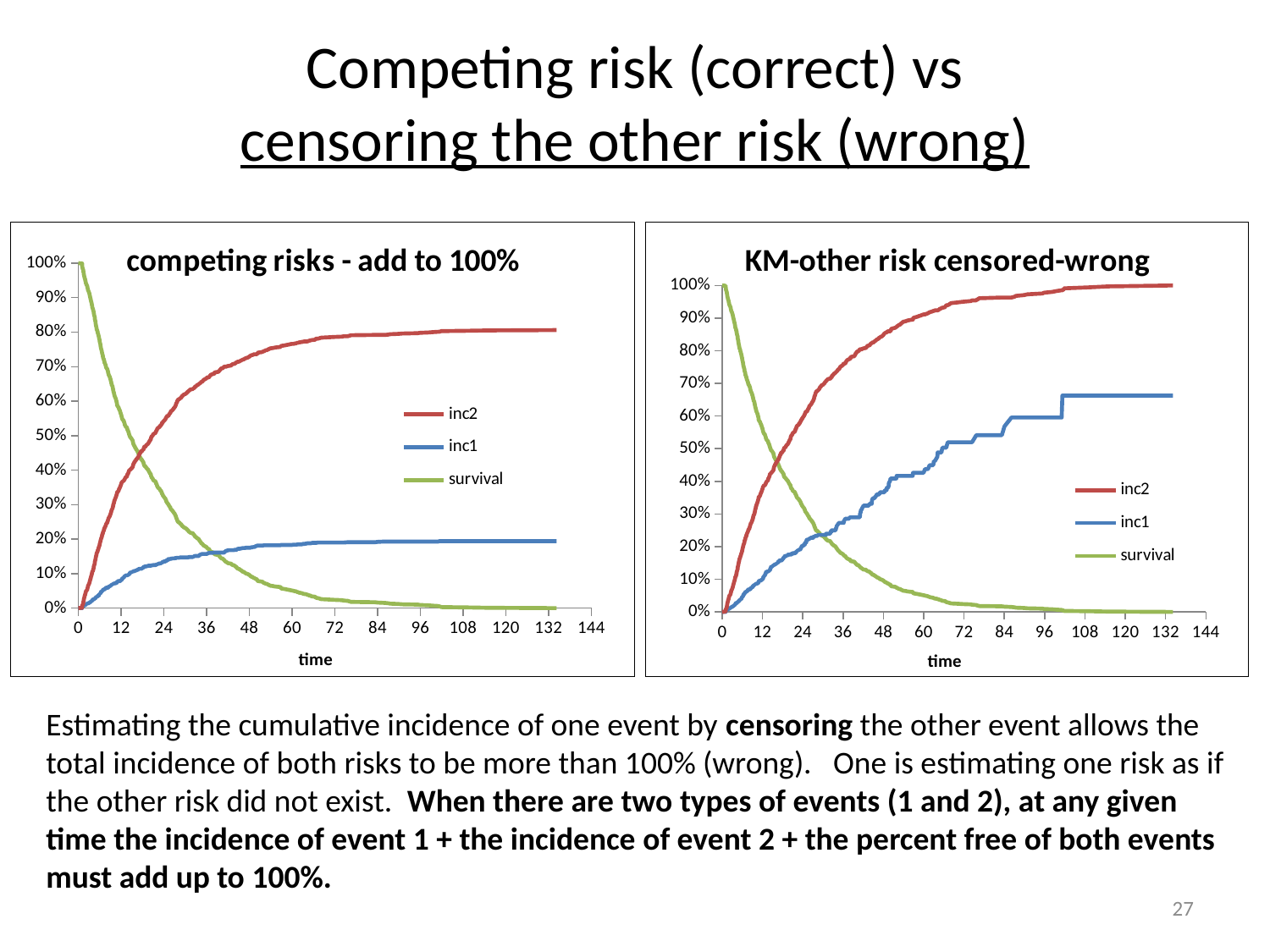
In the right chart "KM-other risk censored-wrong", is the value of survival at time 96 greater or less than 10%? less In the left chart "competing risks - add to 100%", is the value of inc1 at time 132 greater or less than 30%? less In the left chart "competing risks - add to 100%", what is the value of the survival series at time 0? 100% How many series does the legend of the right chart "KM-other risk censored-wrong" list? 3 What type of chart is the left chart titled "competing risks - add to 100%"? line chart In the right chart "KM-other risk censored-wrong", is the value of inc1 at time 132 greater or less than 50%? greater What is the x-axis title of the left chart "competing risks - add to 100%"? time Does the inc2 series in the left chart "competing risks - add to 100%" rise or fall as time increases? rise Does the survival series in the right chart "KM-other risk censored-wrong" rise or fall as time increases? fall In the left chart "competing risks - add to 100%", which series has the higher value at time 132, inc2 or inc1? inc2